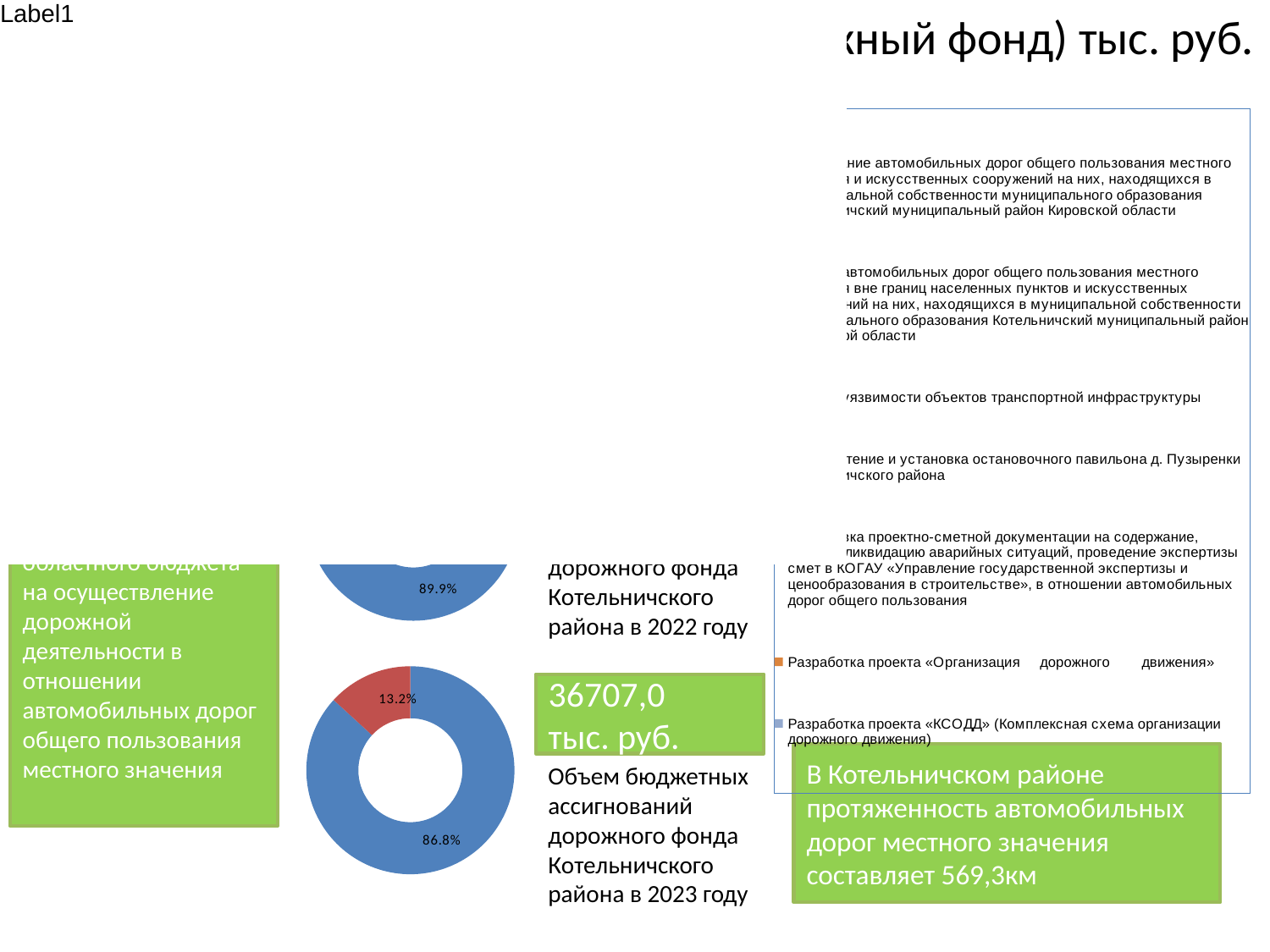
In the lower doughnut chart (2023), which slice is larger: the blue one or the red one? the blue one What colour is the largest slice in the lower doughnut chart (2023)? blue Which legend entry on the slide is marked with an orange square? Разработка проекта «Организация дорожного движения» What percentage label is visible on the upper doughnut chart (2022)? 89.9% How many labelled slices does the lower doughnut chart (2023) show? 2 In the lower doughnut chart (2023), is the value of the red slice greater or less than 50%? less In the lower doughnut chart (2023), is the value of the blue slice greater or less than 50%? greater In the lower doughnut chart (2023), what is the value of the smaller red slice? 13.2% In the lower doughnut chart (2023), what is the value of the largest slice? 86.8% What kind of chart is the lower chart on the slide (for 2023)? doughnut chart In the lower doughnut chart (2023), what is the difference between the two labelled slices, 86.8% and 13.2%? 73.6 percentage points